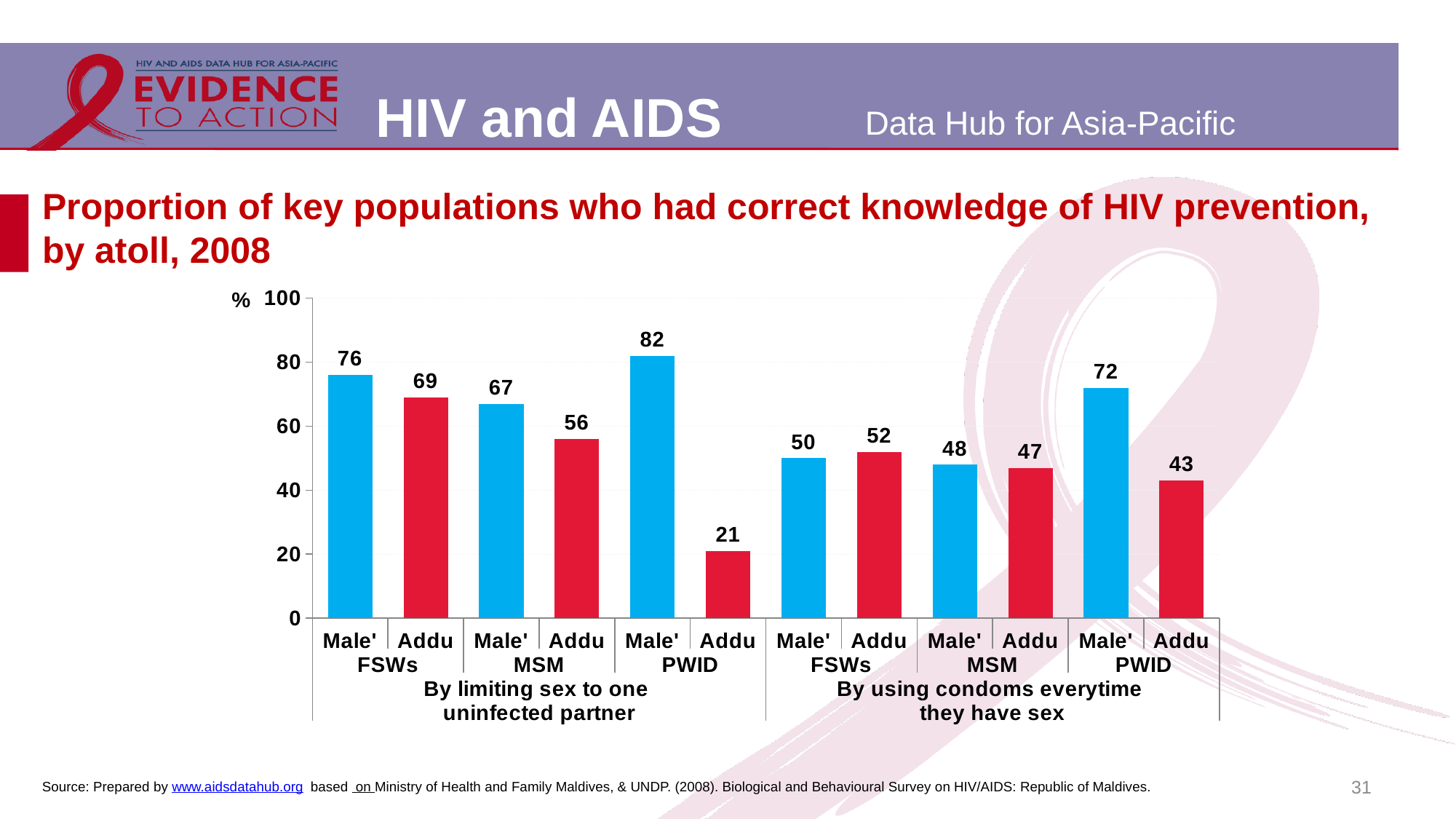
What unit is shown on the y axis of the chart? % How many bars are plotted on the chart? 12 Is the value for Male' MSM under 'By limiting sex to one uninfected partner' greater or less than 60? greater Which bar has the lowest value on the chart? Addu PWID, by limiting sex to one uninfected partner (21) What is the difference between Male' PWID and Addu PWID under 'By using condoms everytime they have sex'? 29 What is the value for Addu FSWs under 'By using condoms everytime they have sex'? 52 What kind of chart is shown on the slide? Bar chart What is the difference between Male' FSWs and Addu FSWs under 'By limiting sex to one uninfected partner'? 7 Under 'By using condoms everytime they have sex', which is larger: Male' MSM or Addu MSM? Male' MSM What is the value for Addu PWID under 'By limiting sex to one uninfected partner'? 21 What is the value for Male' PWID under 'By limiting sex to one uninfected partner'? 82 Which bar has the highest value on the chart? Male' PWID, by limiting sex to one uninfected partner (82)